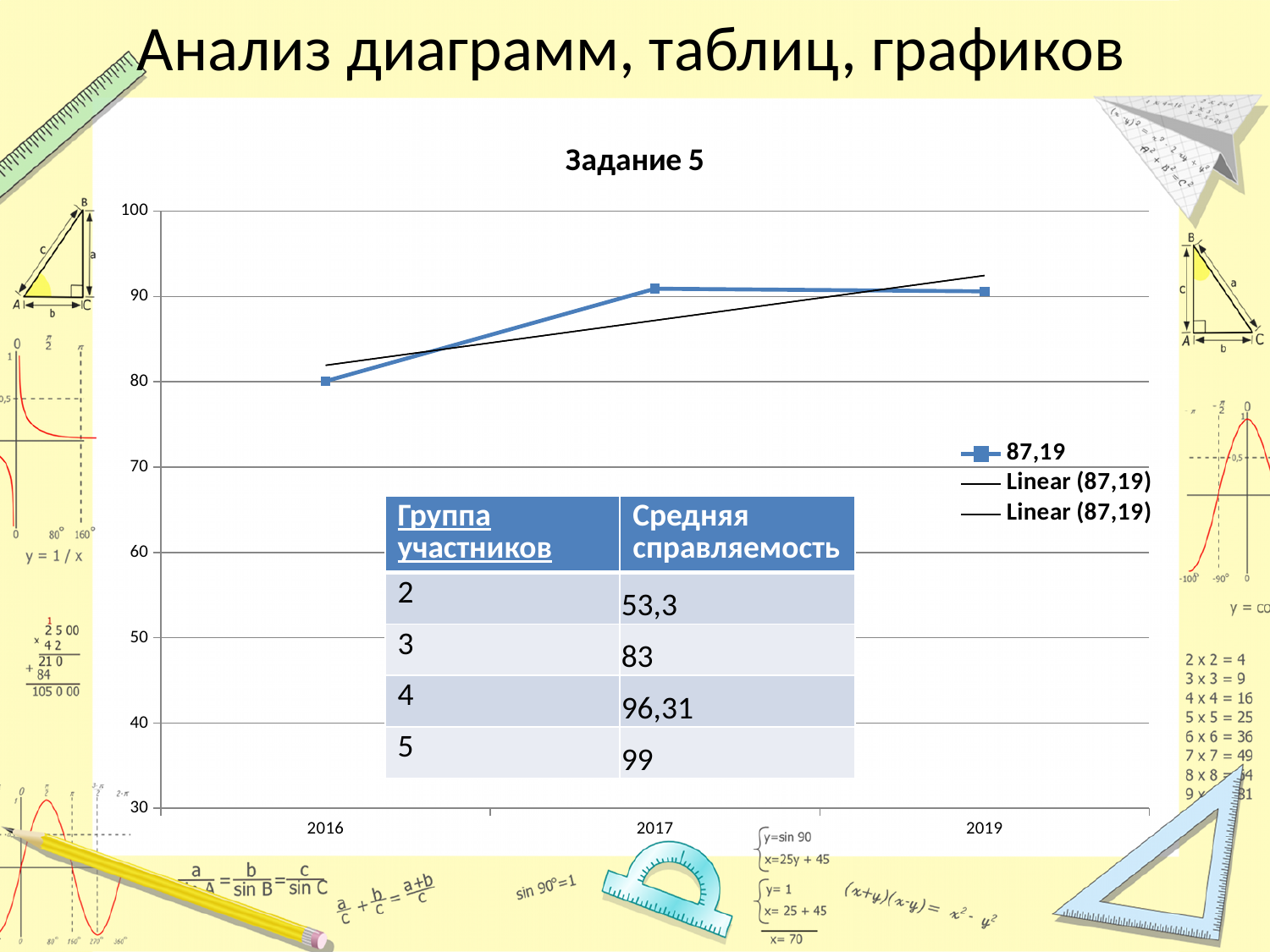
What kind of chart is shown on the slide? line chart What is the title of the chart? Задание 5 Which years are shown on the x axis of the chart? 2016, 2017, 2019 What is the name of the data series shown with blue square markers in the legend? 87,19 Which year has the lowest value on the chart? 2016 Does the value rise or fall from 2016 to 2017? rise How many entries does the chart legend list? 3 Is the value for 2019 greater or less than 80? greater Which is larger, the value for 2016 or the value for 2017? 2017 Is the value for 2017 greater or less than 85? greater How many data points are plotted on the line in the chart? 3